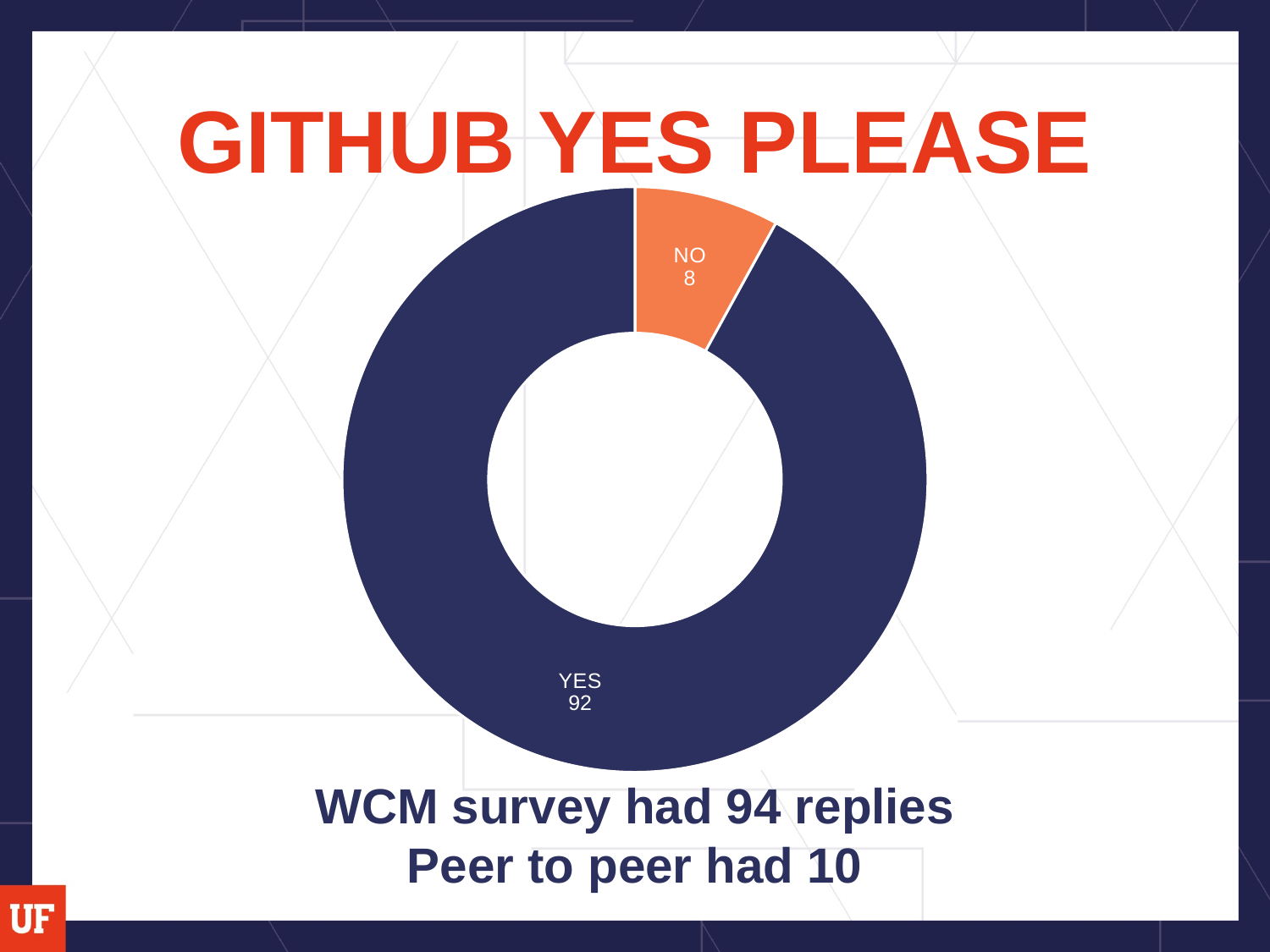
What kind of chart is shown on the slide? doughnut chart Which category has the smallest slice in the chart? NO What share of the chart does the NO slice represent? 8% Which is larger, the value for YES or the value for NO? YES What is the title of the slide above the chart? GITHUB YES PLEASE Which category has the largest slice in the chart? YES What is the value for NO in the chart? 8 What is the value for YES in the chart? 92 What share of the chart does the YES slice represent? 92% What is the total of the values shown in the chart? 100 What is the difference between the YES and NO values? 84 How many categories are shown in the chart? 2